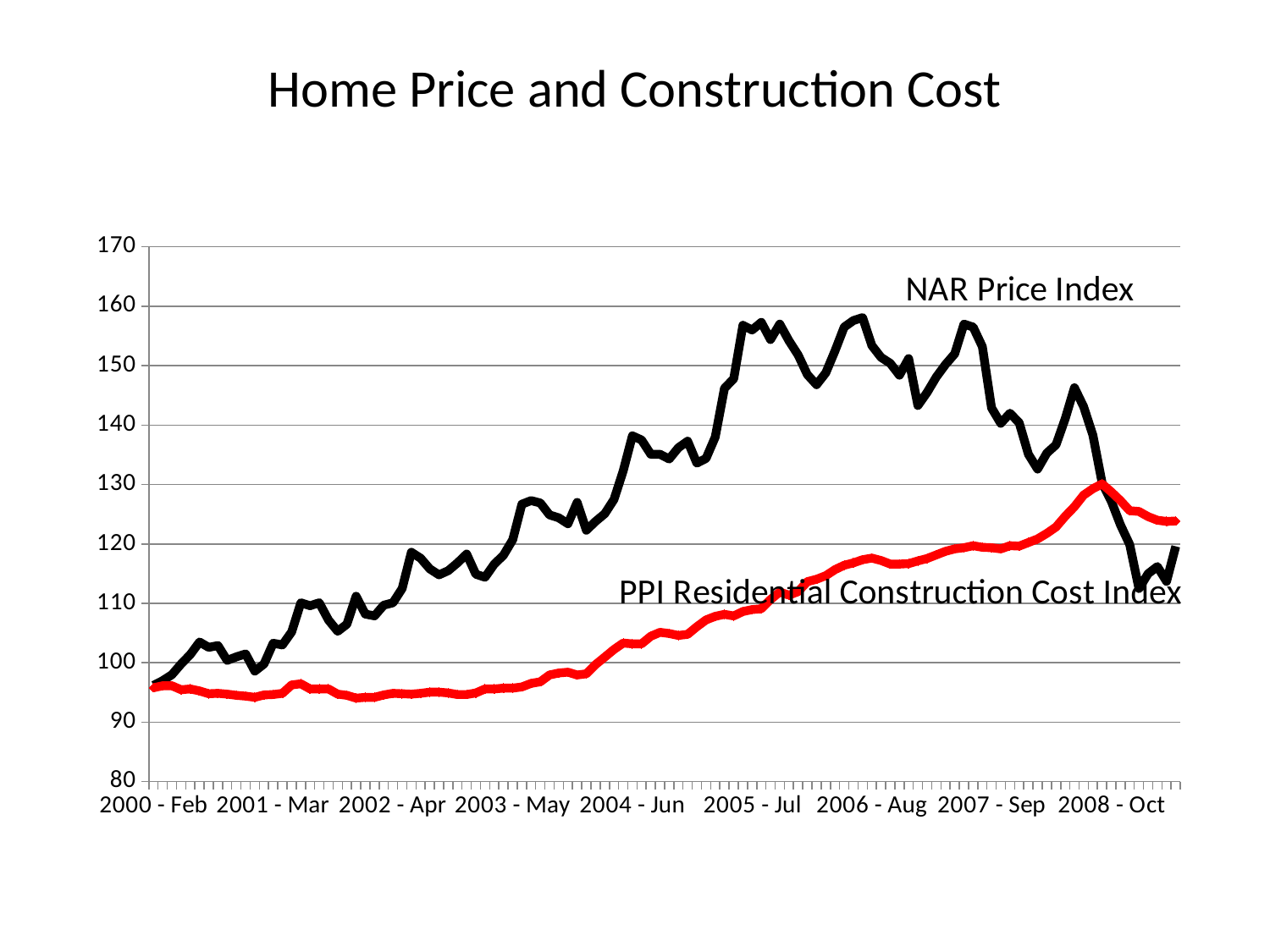
What kind of chart is shown on the slide? line chart Is the value of the PPI Residential Construction Cost Index at 2000 - Feb greater or less than 100? less How many data series are plotted on the chart? 2 Is the value of the PPI Residential Construction Cost Index at 2008 - Oct greater or less than 120? greater How many labelled dates appear on the x axis? 9 Is the value of the NAR Price Index at 2008 - Oct greater or less than 130? less Which series is drawn in red? PPI Residential Construction Cost Index What is the title of the chart? Home Price and Construction Cost At 2006 - Aug, which series has the higher value, the NAR Price Index or the PPI Residential Construction Cost Index? NAR Price Index Which series reaches the highest value anywhere on the chart? NAR Price Index Does the NAR Price Index rise or fall between 2007 - Sep and 2008 - Oct? fall